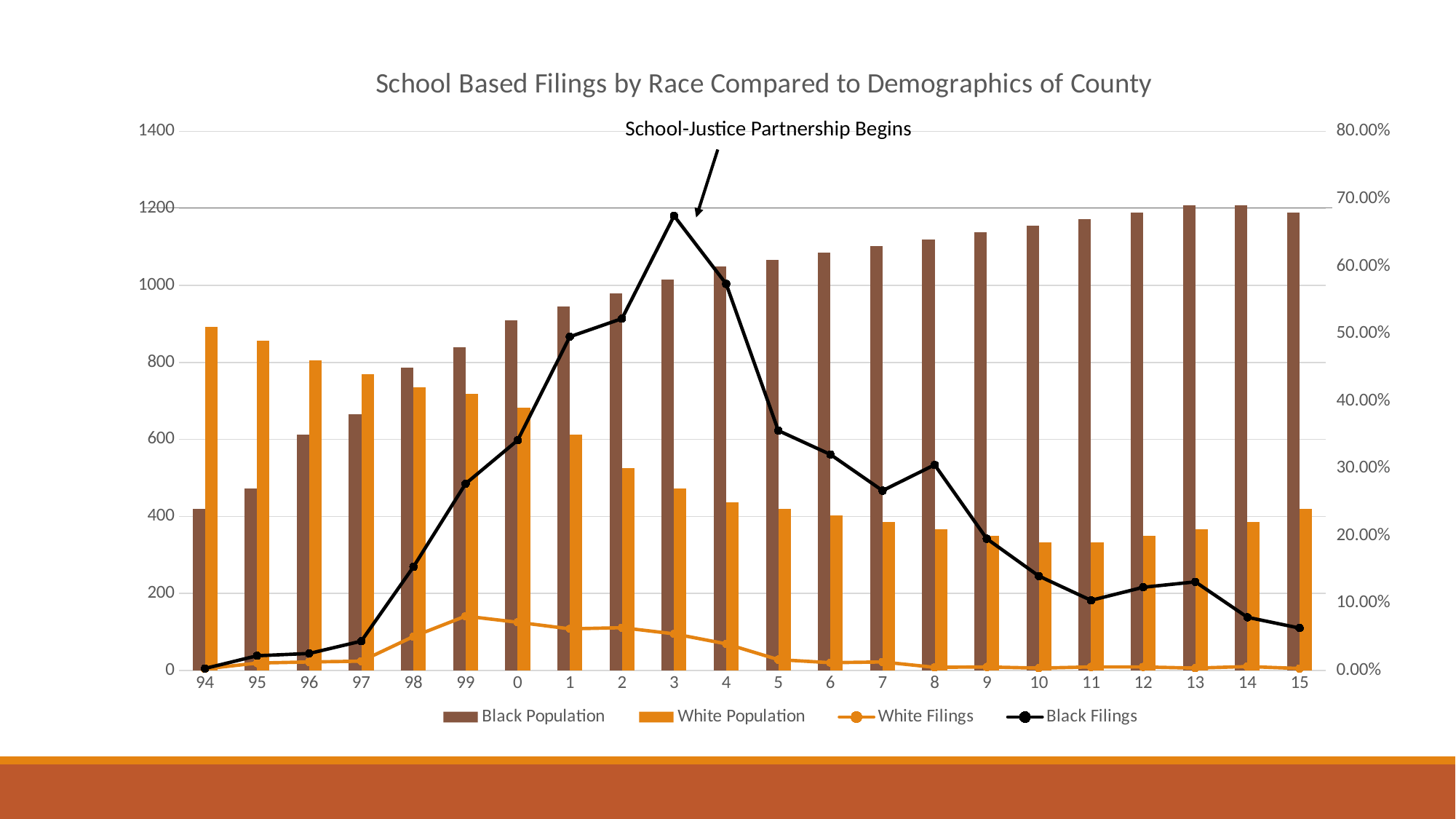
Does the Black Population series generally rise or fall from 94 to 15? rise In year 94, which is larger: Black Population or White Population? White Population What kind of chart is shown on the slide? Combined bar and line chart In which year does the Black Filings line reach its highest point? 3 How many series does the legend list? 4 In which year is the Black Population bar the shortest? 94 In which year is the White Population bar the tallest? 94 How many categories are shown on the x axis? 22